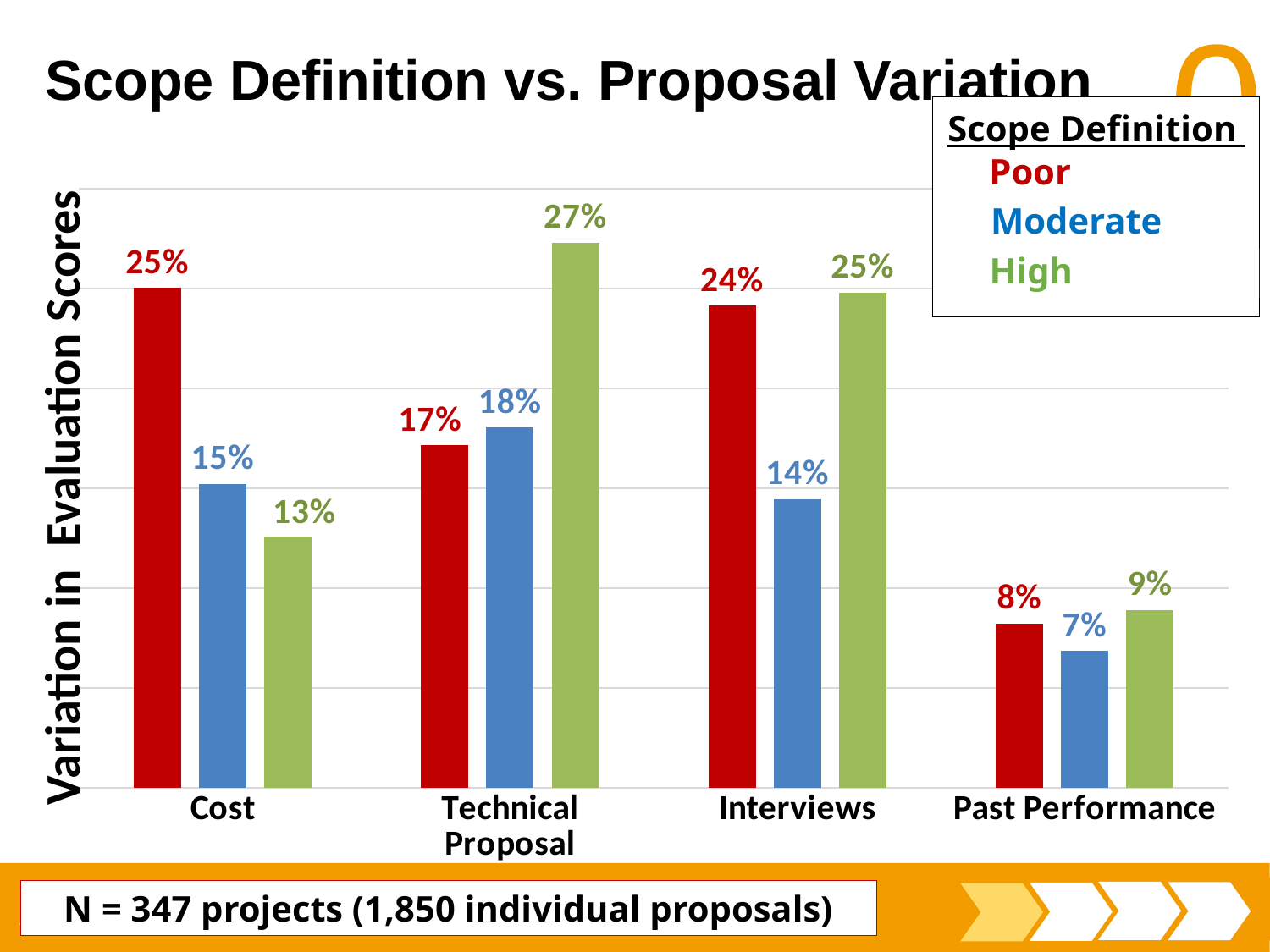
How many series does the legend list? 3 What is the difference between the Poor and High values in the Cost category? 12% What is the value for Poor scope definition in the Cost category? 25% How many categories are shown on the x axis? 4 What is the value for Moderate scope definition in the Past Performance category? 7% What kind of chart is shown on the slide? Bar chart What is the value for Moderate scope definition in the Interviews category? 14% Which category has the lowest value for the High series? Past Performance What is the title of the legend box? Scope Definition Which category has the highest value for the Poor series? Cost What is the value for High scope definition in the Technical Proposal category? 27% Which is larger in the Technical Proposal category, the Poor value or the High value? High